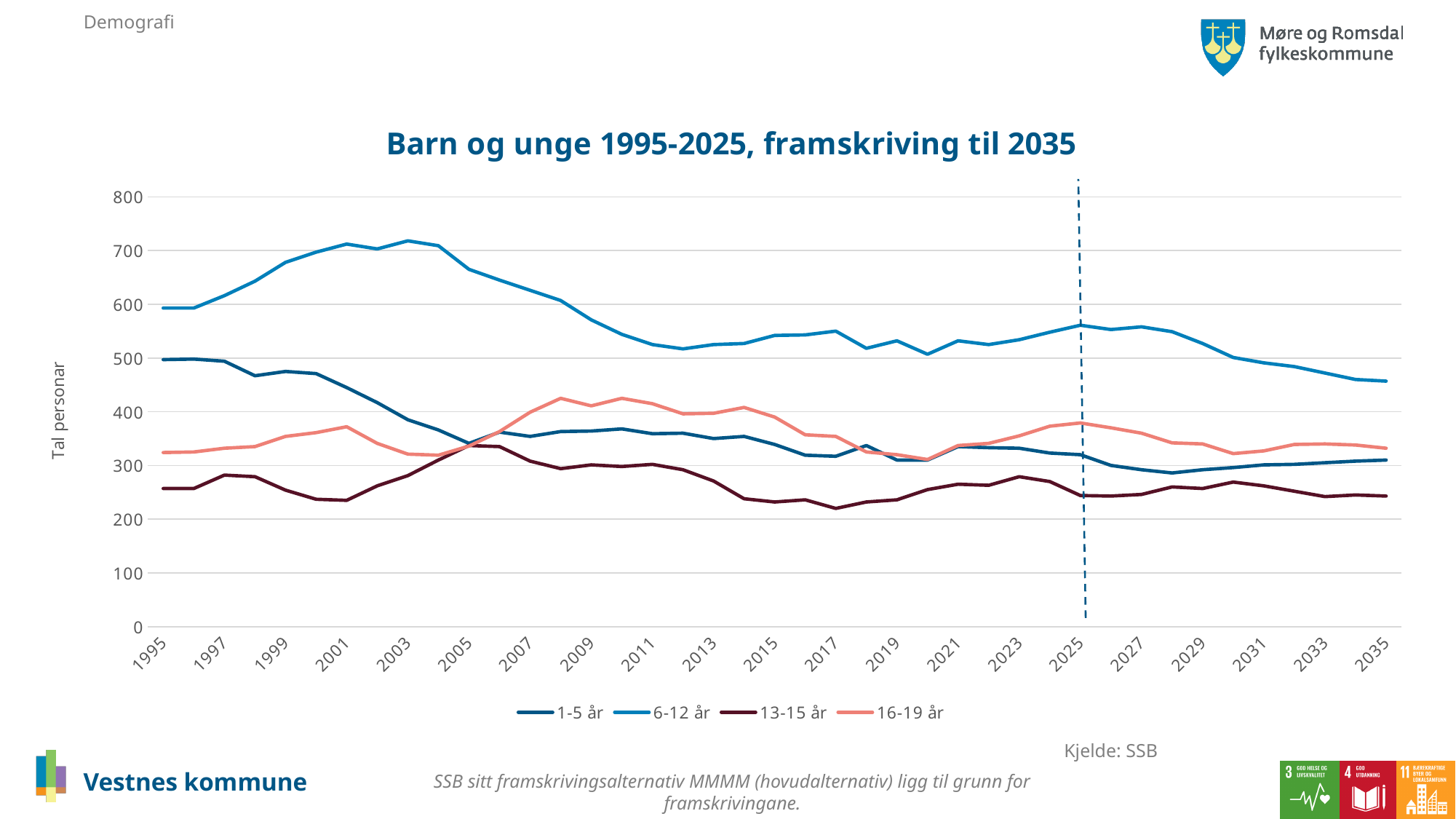
Does the 6-12 år series rise or fall between 2003 and 2011? fall Which series has the highest value in 1995? 6-12 år What is the title of the chart? Barn og unge 1995-2025, framskriving til 2035 Is the value for 13-15 år in 2017 greater or less than 250? less Is the value for 6-12 år in 2003 greater or less than 700? greater Is the value for 16-19 år in 2025 greater or less than 350? greater How many series does the legend list? 4 What is the label on the vertical axis of the chart? Tal personar How many year labels are shown on the x axis? 21 Which series has the lowest value in 2035? 13-15 år In 2009, which series has the larger value: 16-19 år or 1-5 år? 16-19 år What kind of chart is shown on the slide? line chart